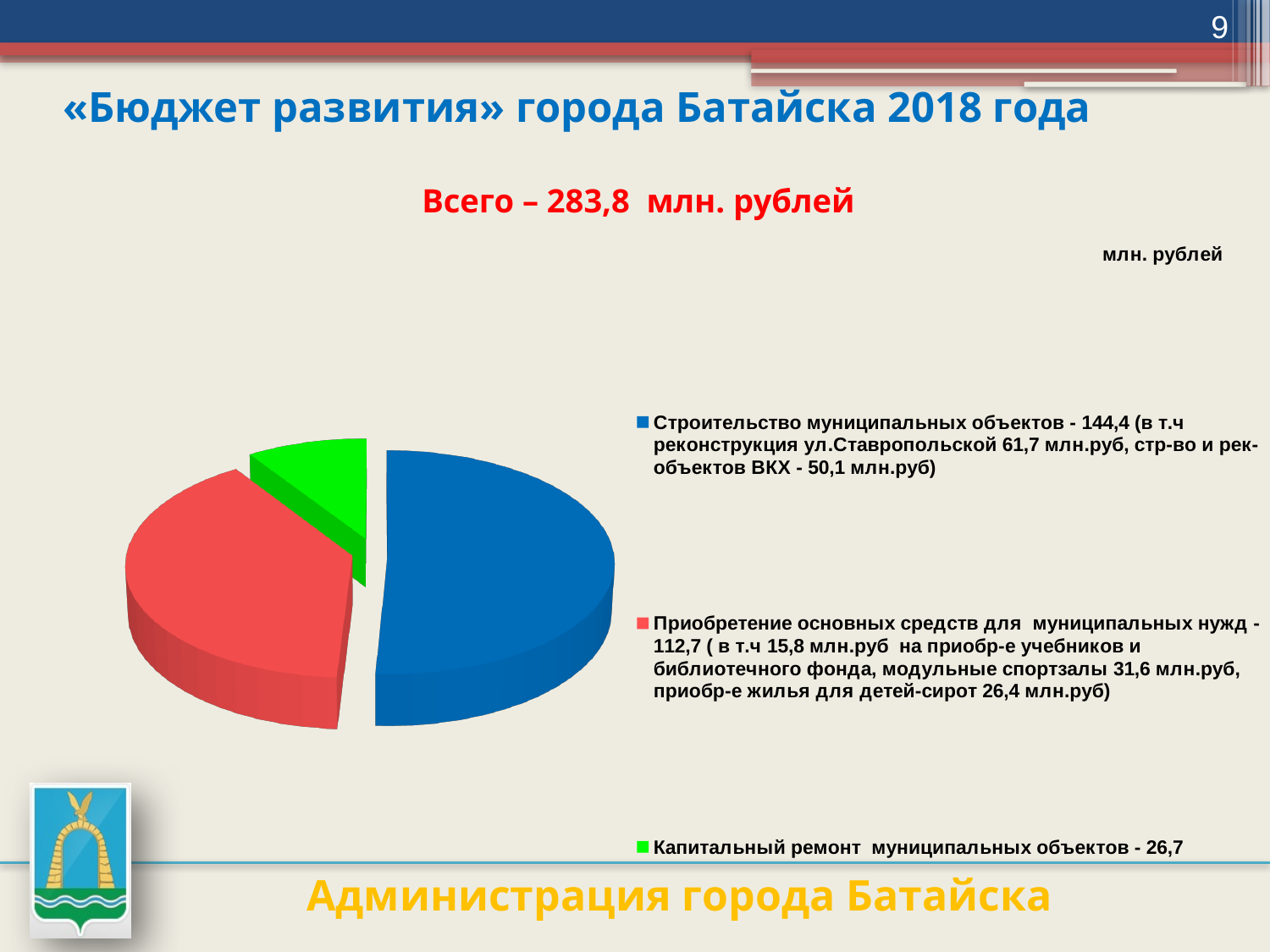
What is the value for «Капитальный ремонт муниципальных объектов» in the pie chart? 26,7 What kind of chart is shown on the slide? pie chart What is the total of the three values shown in the pie chart, in млн. рублей? 283,8 How many entries does the legend of the pie chart list? 3 What is the value for «Строительство муниципальных объектов» in the pie chart? 144,4 What colour is the slice for «Капитальный ремонт муниципальных объектов» in the pie chart? green Which is larger: the value for «Приобретение основных средств для муниципальных нужд» or for «Капитальный ремонт муниципальных объектов»? Приобретение основных средств для муниципальных нужд What is the difference between the values for «Строительство муниципальных объектов» and «Приобретение основных средств для муниципальных нужд»? 31,7 Which category has the smallest slice in the pie chart? Капитальный ремонт муниципальных объектов Which category has the largest slice in the pie chart? Строительство муниципальных объектов What is the value for «Приобретение основных средств для муниципальных нужд» in the pie chart? 112,7 How many slices does the pie chart have? 3